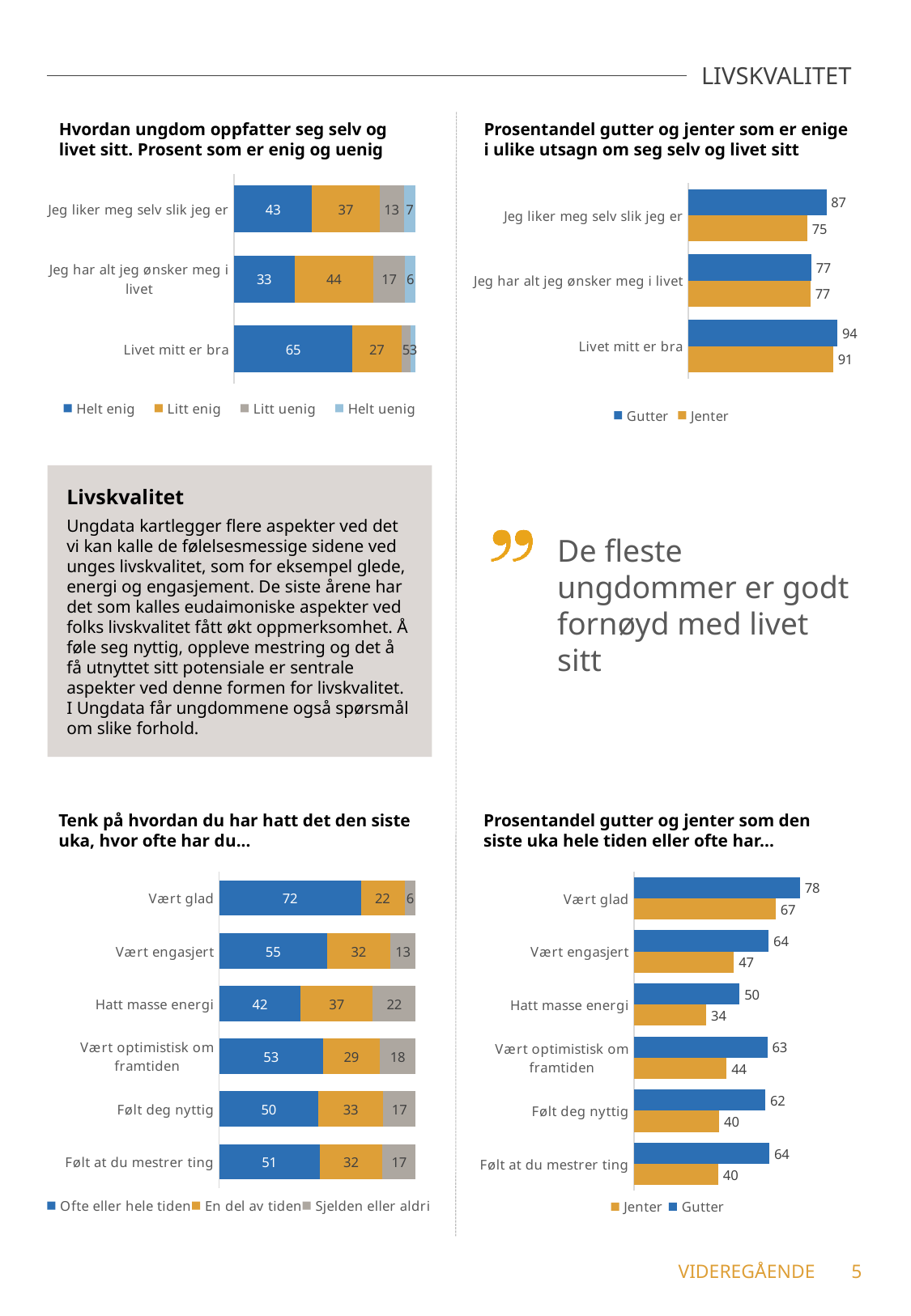
In the top-right chart 'Prosentandel gutter og jenter som er enige i ulike utsagn om seg selv og livet sitt', which statement has the highest Jenter value? Livet mitt er bra In the top-left chart 'Hvordan ungdom oppfatter seg selv og livet sitt', what is the 'Helt enig' value for 'Livet mitt er bra'? 65 In the top-left chart 'Hvordan ungdom oppfatter seg selv og livet sitt', how many series does the legend list? 4 In the top-right chart 'Prosentandel gutter og jenter som er enige i ulike utsagn om seg selv og livet sitt', what is the Gutter value for 'Jeg liker meg selv slik jeg er'? 87 In the bottom-right chart 'Prosentandel gutter og jenter som den siste uka hele tiden eller ofte har…', what is the Jenter value for 'Hatt masse energi'? 34 What kind of chart is the bottom-left chart 'Tenk på hvordan du har hatt det den siste uka, hvor ofte har du…'? Stacked bar chart In the bottom-left chart 'Tenk på hvordan du har hatt det den siste uka, hvor ofte har du…', how many categories are shown? 6 In the bottom-right chart 'Prosentandel gutter og jenter som den siste uka hele tiden eller ofte har…', which is larger for 'Følt at du mestrer ting': Gutter or Jenter? Gutter In the bottom-left chart 'Tenk på hvordan du har hatt det den siste uka, hvor ofte har du…', which category has the lowest 'Ofte eller hele tiden' value? Hatt masse energi In the bottom-left chart 'Tenk på hvordan du har hatt det den siste uka, hvor ofte har du…', what is the 'Sjelden eller aldri' value for 'Vært engasjert'? 13 In the top-left chart 'Hvordan ungdom oppfatter seg selv og livet sitt', what is the 'Litt enig' value for 'Jeg har alt jeg ønsker meg i livet'? 44 In the top-right chart 'Prosentandel gutter og jenter som er enige i ulike utsagn om seg selv og livet sitt', what is the difference between Gutter and Jenter for 'Jeg liker meg selv slik jeg er'? 12